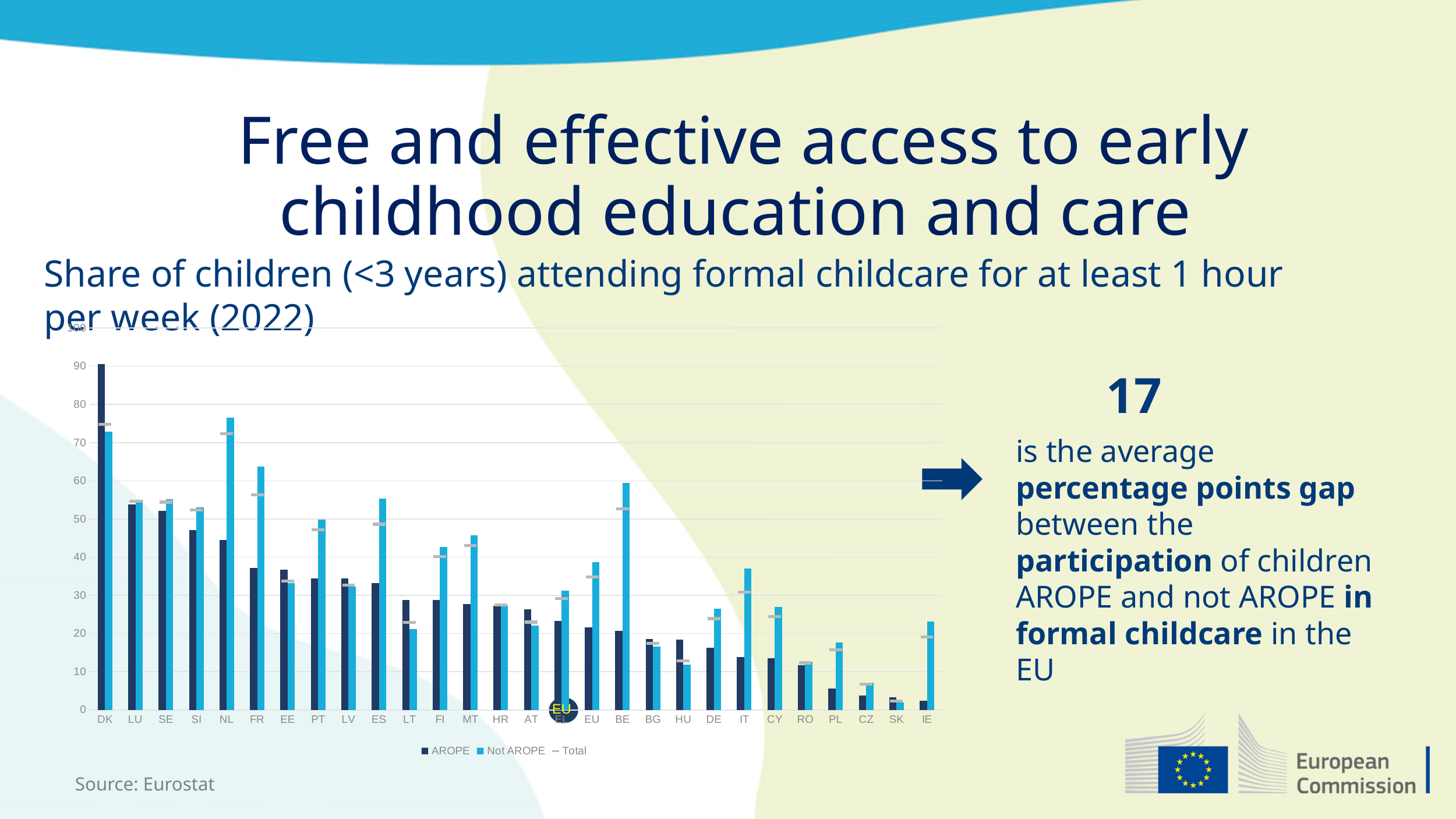
Is the Not AROPE value for BE greater or less than 50? greater For FR, which is larger: the AROPE value or the Not AROPE value? Not AROPE Is the AROPE value for IE greater or less than 10? less Which country has the highest Not AROPE value in the chart? NL Which country has the highest AROPE value in the chart? DK What kind of chart is shown on the slide? Bar chart Which country has the lowest Not AROPE value in the chart? SK Do the Total values generally rise or fall from left to right across the countries? Fall How many series does the chart legend list? 3 Is the Not AROPE value for NL greater or less than 70? greater For DK, which is larger: the AROPE value or the Not AROPE value? AROPE